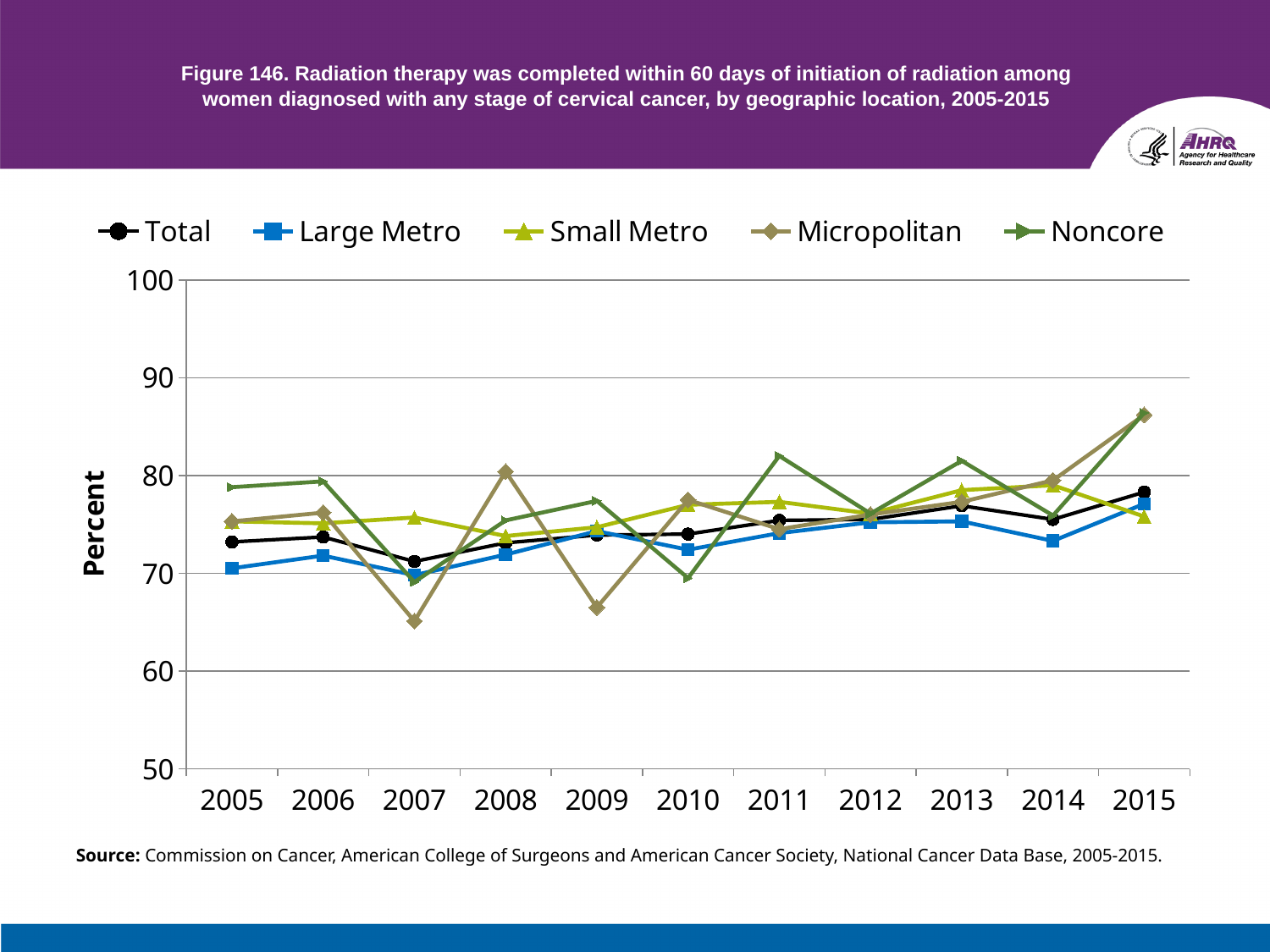
Is the value for Noncore in 2011 greater or less than 80? greater Which series has the lowest value in 2010? Noncore How many series does the legend list? 5 In which year is the Total value highest? 2015 In which year is the Micropolitan value lowest? 2007 In 2007, which is larger: Small Metro or Micropolitan? Small Metro Is the value for Micropolitan in 2009 greater or less than 70? less What is the label on the y axis? Percent What kind of chart is shown on the slide? Line chart Is the value for Micropolitan in 2007 greater or less than 70? less In 2011, which is larger: Noncore or Large Metro? Noncore How many years are plotted along the x axis? 11